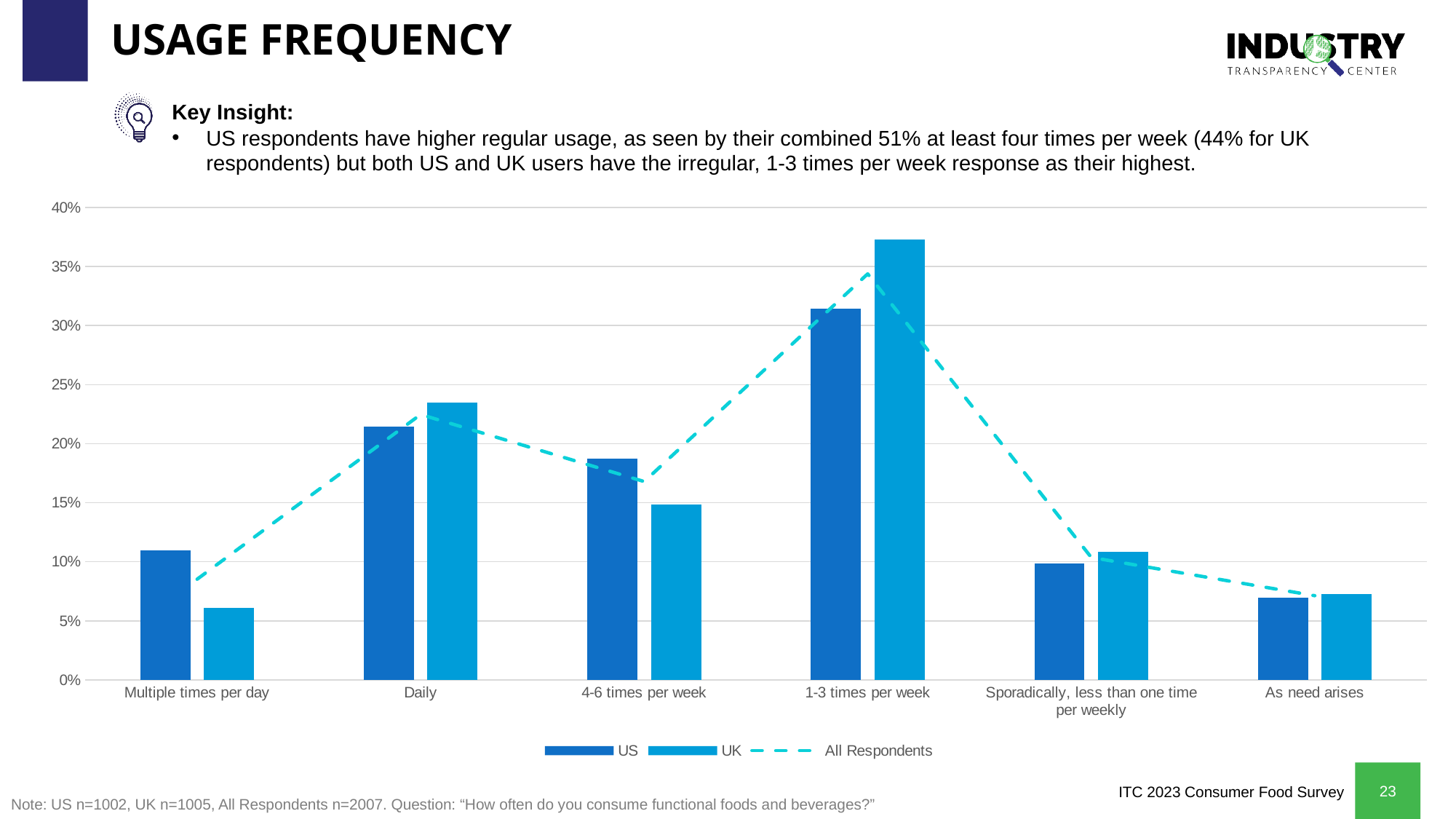
How many usage frequency categories are shown on the x axis? 6 Which category has the lowest value for the US series? As need arises Which series is drawn as a dashed line rather than bars? All Respondents Which category has the highest value for the US series? 1-3 times per week Is the UK value for 1-3 times per week greater or less than 35%? greater How many series does the legend list? 3 Is the US value for Daily greater or less than 20%? greater For Multiple times per day, which series has the larger value, US or UK? US What kind of chart is shown on the slide? combination bar and line chart Is the UK value for Multiple times per day greater or less than 10%? less For 4-6 times per week, which series has the larger value, US or UK? US Which category has the highest value for the UK series? 1-3 times per week